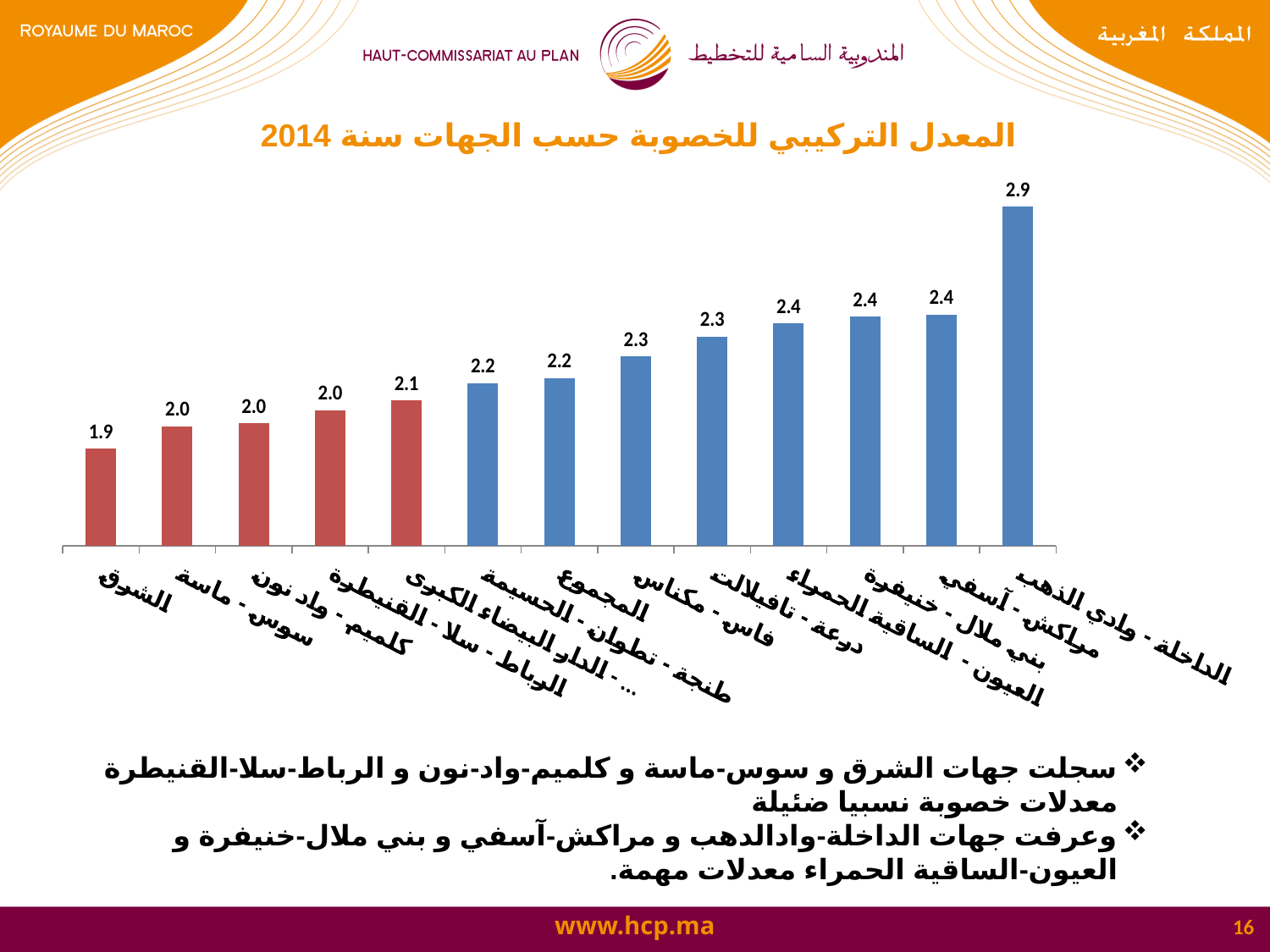
Which region has the highest value? الداخلة - وادي الذهب What is the value for الشرق? 1.9 Do the values rise or fall from left to right along the x axis? Rise What is the value for فاس - مكناس? 2.3 What is the value for الداخلة - وادي الذهب? 2.9 What kind of chart is shown on the slide? Bar chart Which is larger, the value for مراكش - آسفي or the value for سوس - ماسة? مراكش - آسفي Which region has the lowest value? الشرق What is the difference between the values for الداخلة - وادي الذهب and الشرق? 1.0 How many regions (bars) are shown in the chart? 13 What is the value for الرباط - سلا - القنيطرة? 2.0 What is the value for المجموع? 2.2